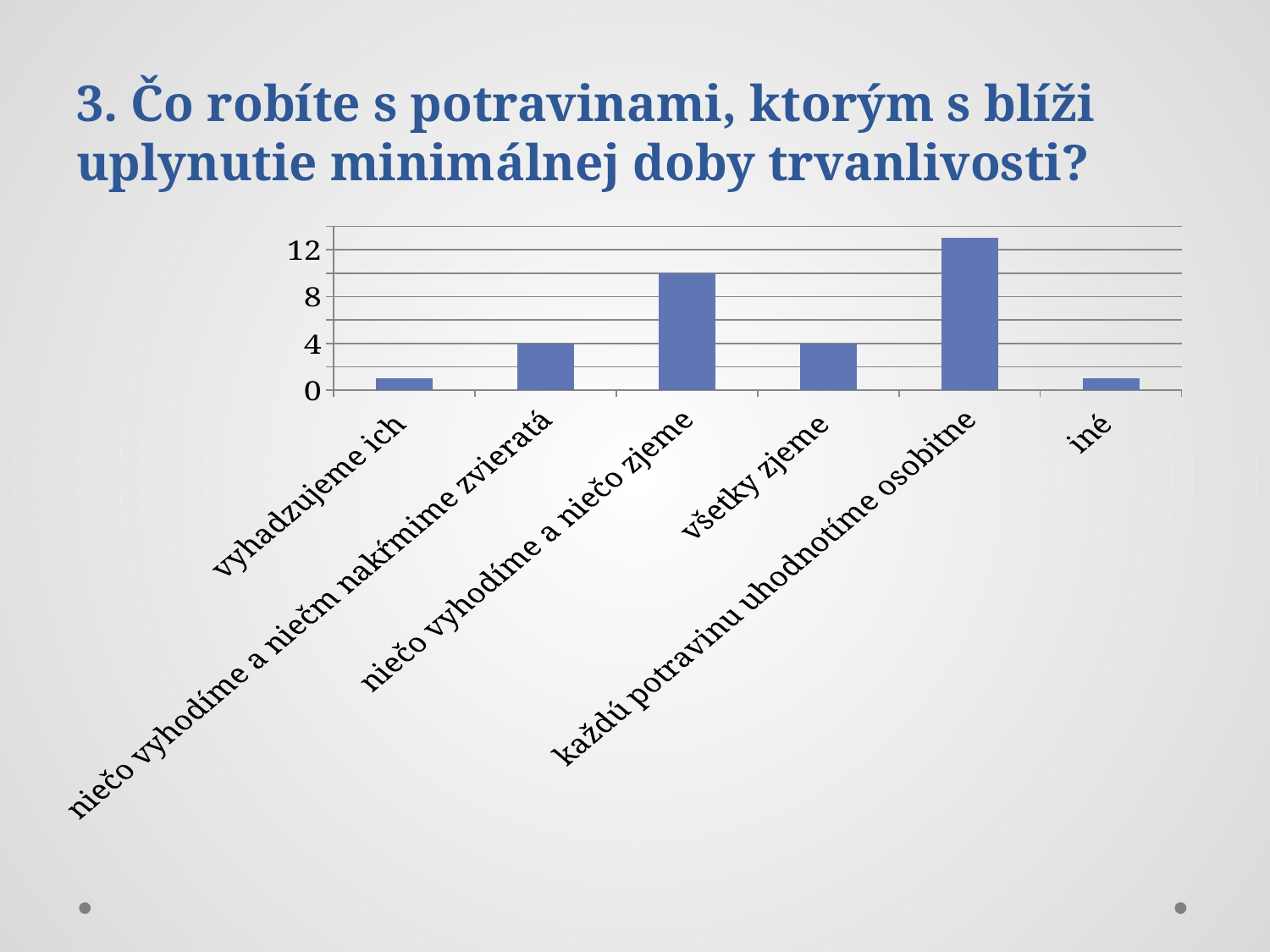
What is the value for "všetky zjeme"? 4 What is the title of the slide containing the chart? 3. Čo robíte s potravinami, ktorým s blíži uplynutie minimálnej doby trvanlivosti? Is the value for "každú potravinu uhodnotíme osobitne" greater or less than 12? greater How many categories are shown on the x axis of the chart? 6 Is the value for "iné" greater or less than 4? less What is the value for "niečo vyhodíme a niečm nakŕmime zvieratá"? 4 Is the value for "niečo vyhodíme a niečo zjeme" greater or less than 8? greater Which is larger, the value for "niečo vyhodíme a niečo zjeme" or the value for "všetky zjeme"? niečo vyhodíme a niečo zjeme Which category has the highest value in the chart? každú potravinu uhodnotíme osobitne What kind of chart is shown on the slide? bar chart Which is larger, the value for "každú potravinu uhodnotíme osobitne" or the value for "niečo vyhodíme a niečo zjeme"? každú potravinu uhodnotíme osobitne